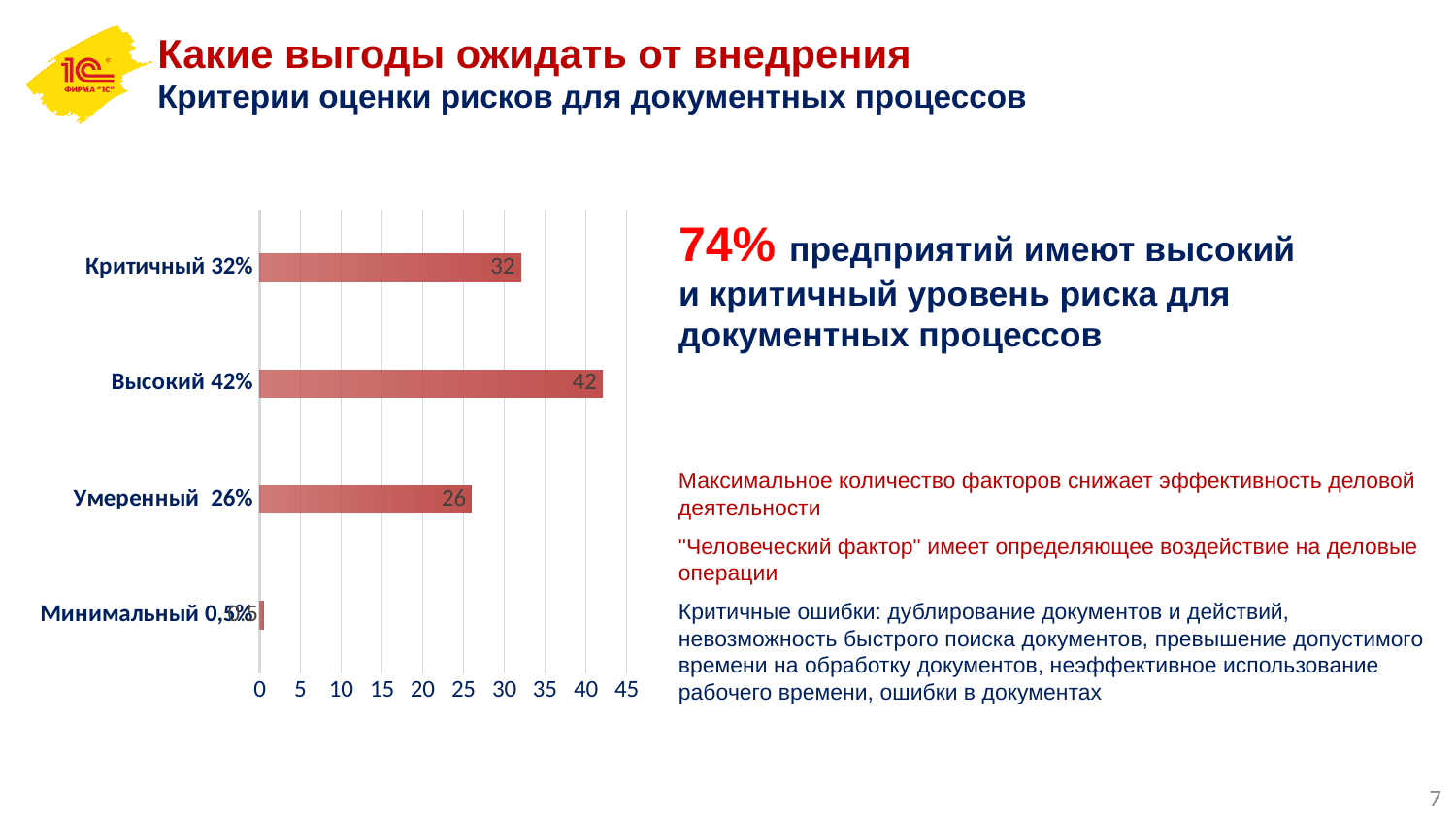
What is the maximum value shown on the chart's horizontal axis? 45 Is the value for Высокий 42% greater or less than 40? greater Which is larger, the value for Критичный 32% or the value for Умеренный 26%? Критичный 32% What is the value for Высокий 42%? 42 What kind of chart is shown on the slide? bar chart How many categories are shown in the chart? 4 Which category has the lowest value? Минимальный 0,5% What is the difference between the values for Высокий 42% and Критичный 32%? 10 What is the value for Умеренный 26%? 26 Which category has the highest value? Высокий 42% What is the difference between the values for Критичный 32% and Умеренный 26%? 6 What is the value for Критичный 32%? 32